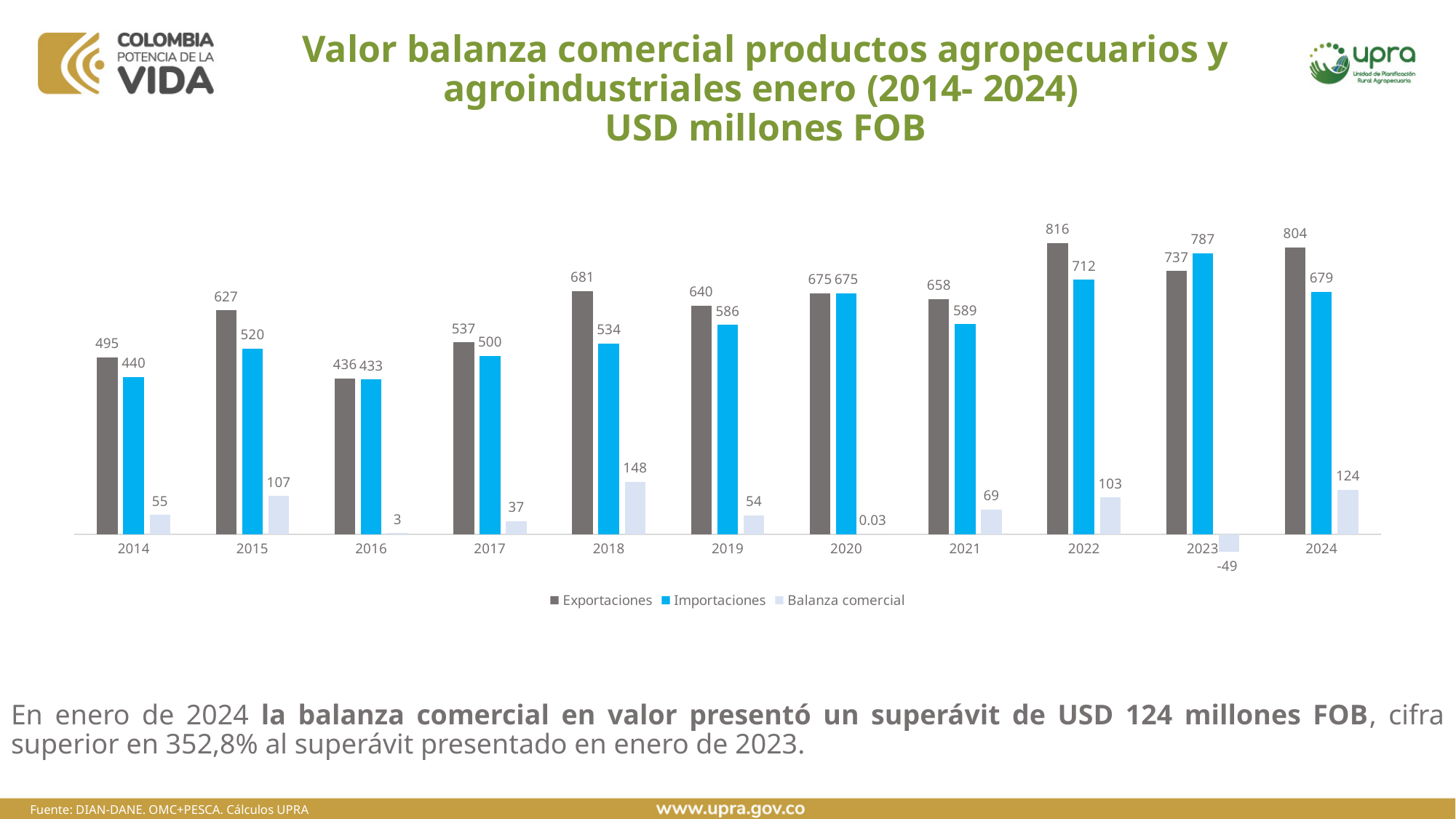
What is the value of Balanza comercial in 2020? 0.03 Which year has the highest value for Exportaciones? 2022 How many series does the legend list? 3 Which series is shown in blue in the legend? Importaciones What is the value of Importaciones in 2023? 787 Which is larger in 2023, Exportaciones or Importaciones? Importaciones How many years are shown on the x axis? 11 What is the value of Exportaciones in 2024? 804 Which year has the lowest value for Balanza comercial? 2023 What is the value of Balanza comercial in 2018? 148 What kind of chart is shown on the slide? Bar chart What is the difference between Exportaciones and Importaciones in 2022? 104